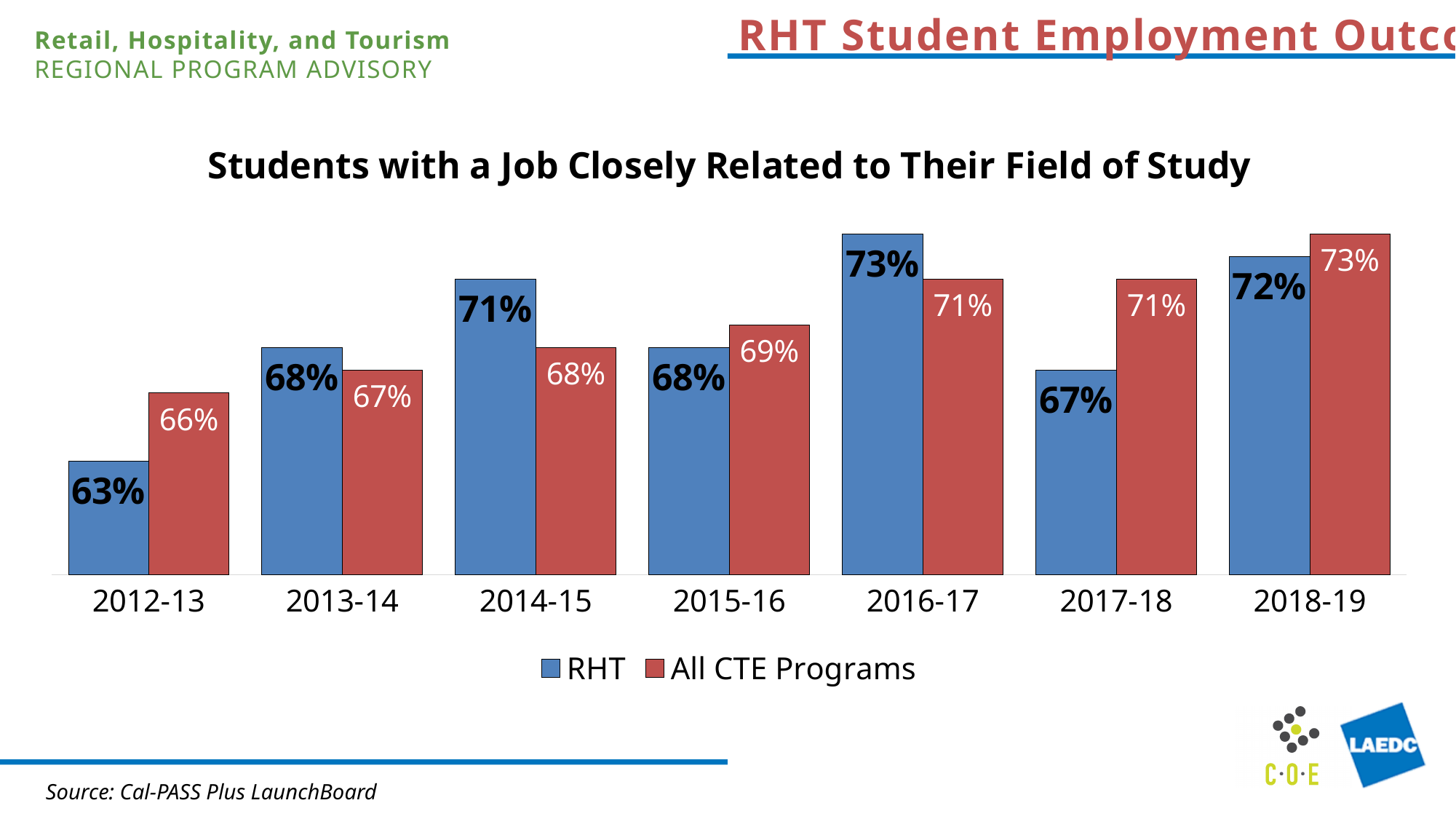
Which is larger in 2014-15, the RHT value or the All CTE Programs value? RHT What is the RHT value for 2012-13? 63% How many series does the legend list? 2 What kind of chart is this? Bar chart In which year is the RHT value highest? 2016-17 What is the All CTE Programs value for 2017-18? 71% What is the RHT value for 2016-17? 73% In which year is the All CTE Programs value lowest? 2012-13 What is the difference between the All CTE Programs value and the RHT value in 2017-18? 4% In which year is the RHT value lowest? 2012-13 How many years are shown on the x axis? 7 What is the title of the chart? Students with a Job Closely Related to Their Field of Study